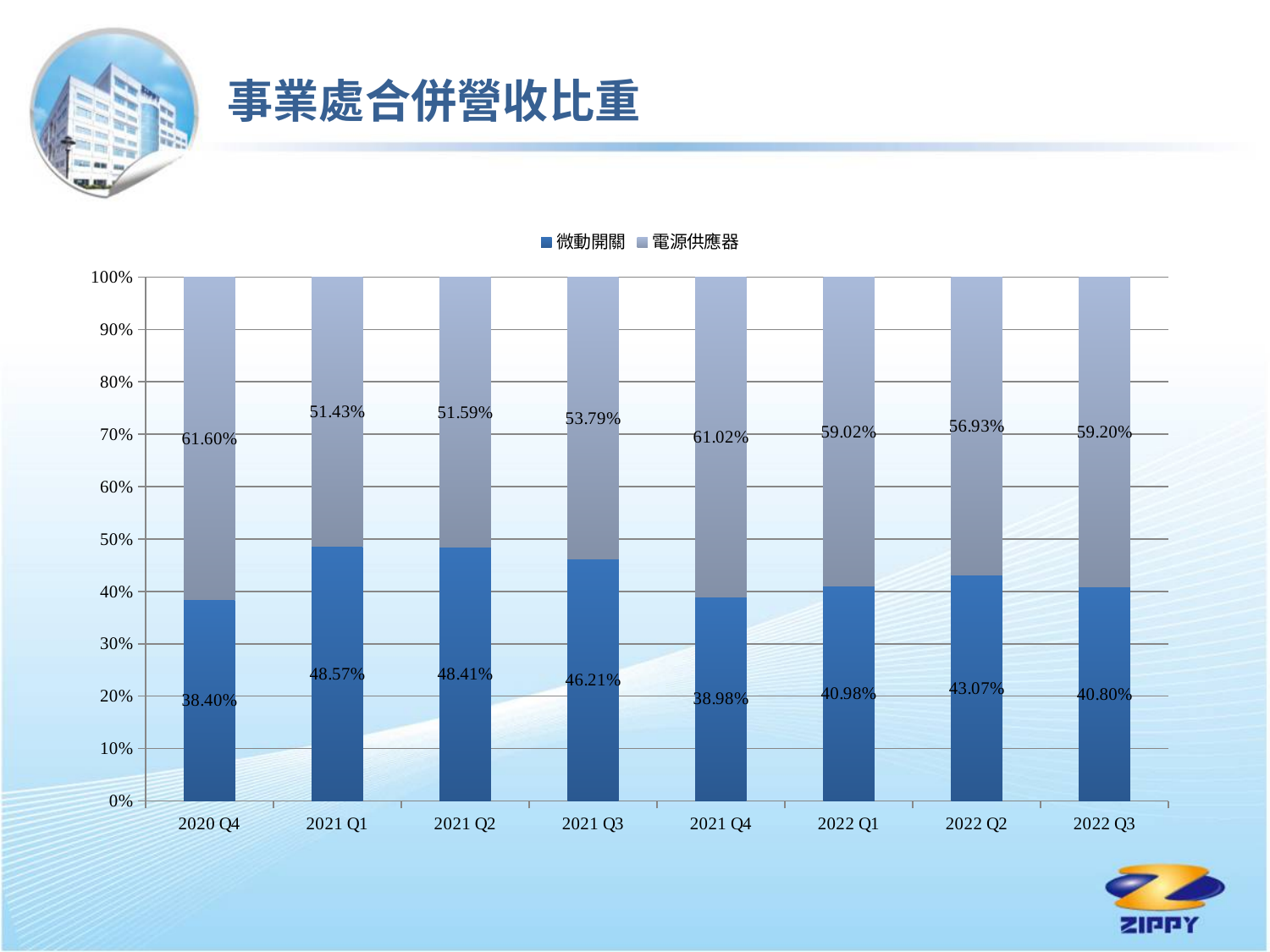
What is the value for 微動開關 in 2022 Q2? 43.07% Which is larger in 2022 Q3: the 微動開關 share or the 電源供應器 share? 電源供應器 How many quarters are shown on the x axis? 8 In which quarter is the 微動開關 share lowest? 2020 Q4 What is the value for 電源供應器 in 2021 Q3? 53.79% What is the value for 電源供應器 in 2020 Q4? 61.60% What is the difference between the 電源供應器 share and the 微動開關 share in 2021 Q4? 22.04% How many series does the legend list? 2 What is the value for 微動開關 in 2021 Q1? 48.57% In which quarter is the 電源供應器 share lowest? 2021 Q1 In which quarter is the 微動開關 share highest? 2021 Q1 What kind of chart is shown on the slide? Stacked bar chart